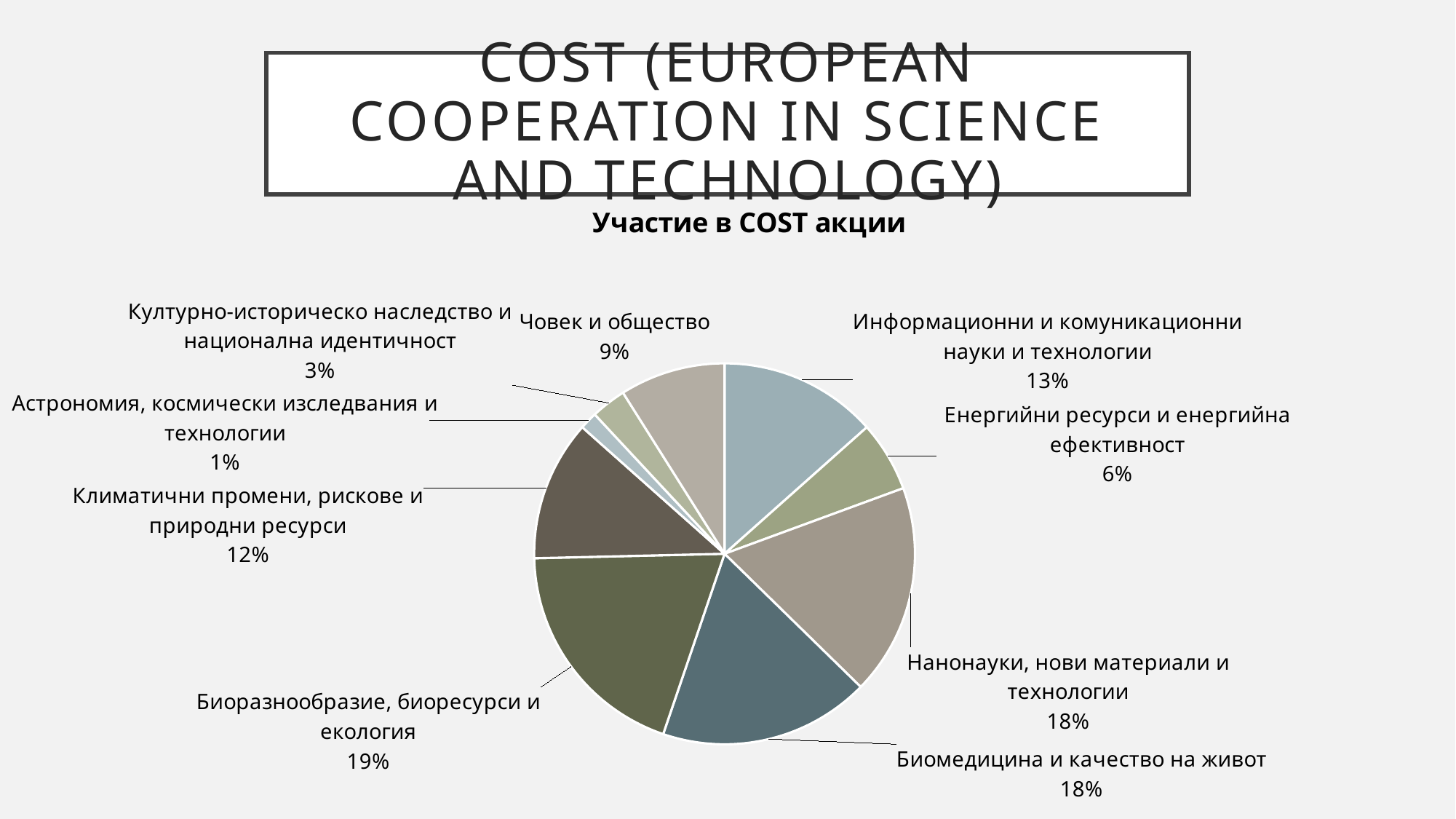
What percentage is shown for "Климатични промени, рискове и природни ресурси"? 12% What is the title of the chart? Участие в COST акции What is the difference in percentage points between "Човек и общество" and "Астрономия, космически изследвания и технологии"? 8 Which category has the smallest share of the pie? Астрономия, космически изследвания и технологии What percentage is shown for "Информационни и комуникационни науки и технологии"? 13% What share of the pie is labelled for "Биоразнообразие, биоресурси и екология"? 19% What is the difference in percentage points between "Нанонауки, нови материали и технологии" and "Енергийни ресурси и енергийна ефективност"? 12 Which has a larger share: "Човек и общество" or "Културно-историческо наследство и национална идентичност"? Човек и общество What percentage is shown for "Биомедицина и качество на живот"? 18% What kind of chart is shown on the slide? pie chart How many categories (slices) does the pie chart have? 9 Which category has the largest share of the pie? Биоразнообразие, биоресурси и екология